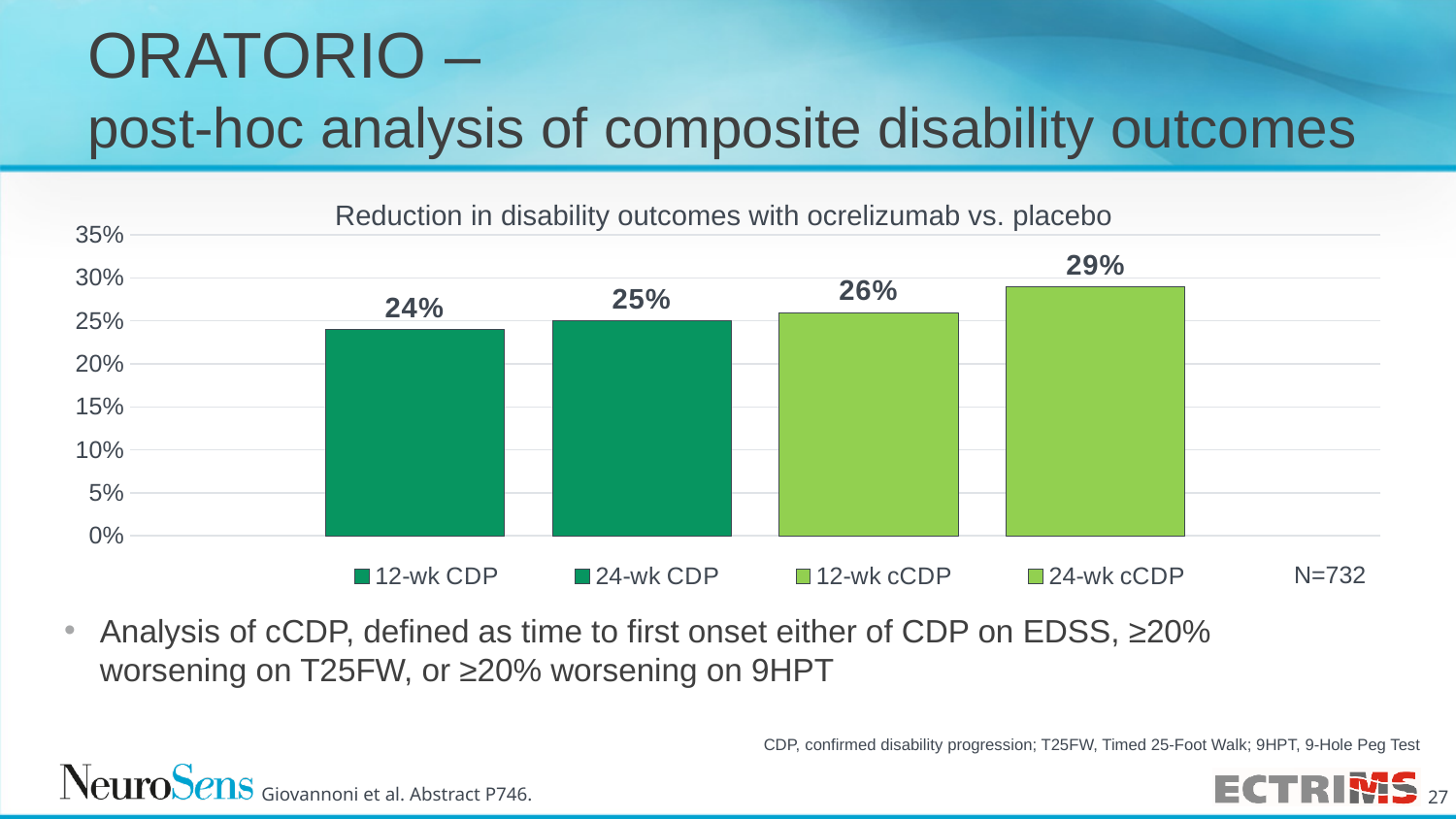
What kind of chart is shown on the slide? Bar chart Which outcome shows the lowest reduction with ocrelizumab vs. placebo? 12-wk CDP How many entries does the legend list? 4 What is the reduction in disability outcomes for 12-wk CDP? 24% How many bars are plotted in the chart? 4 Which is larger, the value for 24-wk CDP or the value for 12-wk cCDP? 12-wk cCDP What is the title of the chart? Reduction in disability outcomes with ocrelizumab vs. placebo Which outcome shows the highest reduction with ocrelizumab vs. placebo? 24-wk cCDP Is the value for 24-wk cCDP greater or less than 25%? greater What is the reduction in disability outcomes for 24-wk cCDP? 29% What is the value shown for 12-wk cCDP? 26% What is the difference between the values for 24-wk cCDP and 12-wk CDP? 5%